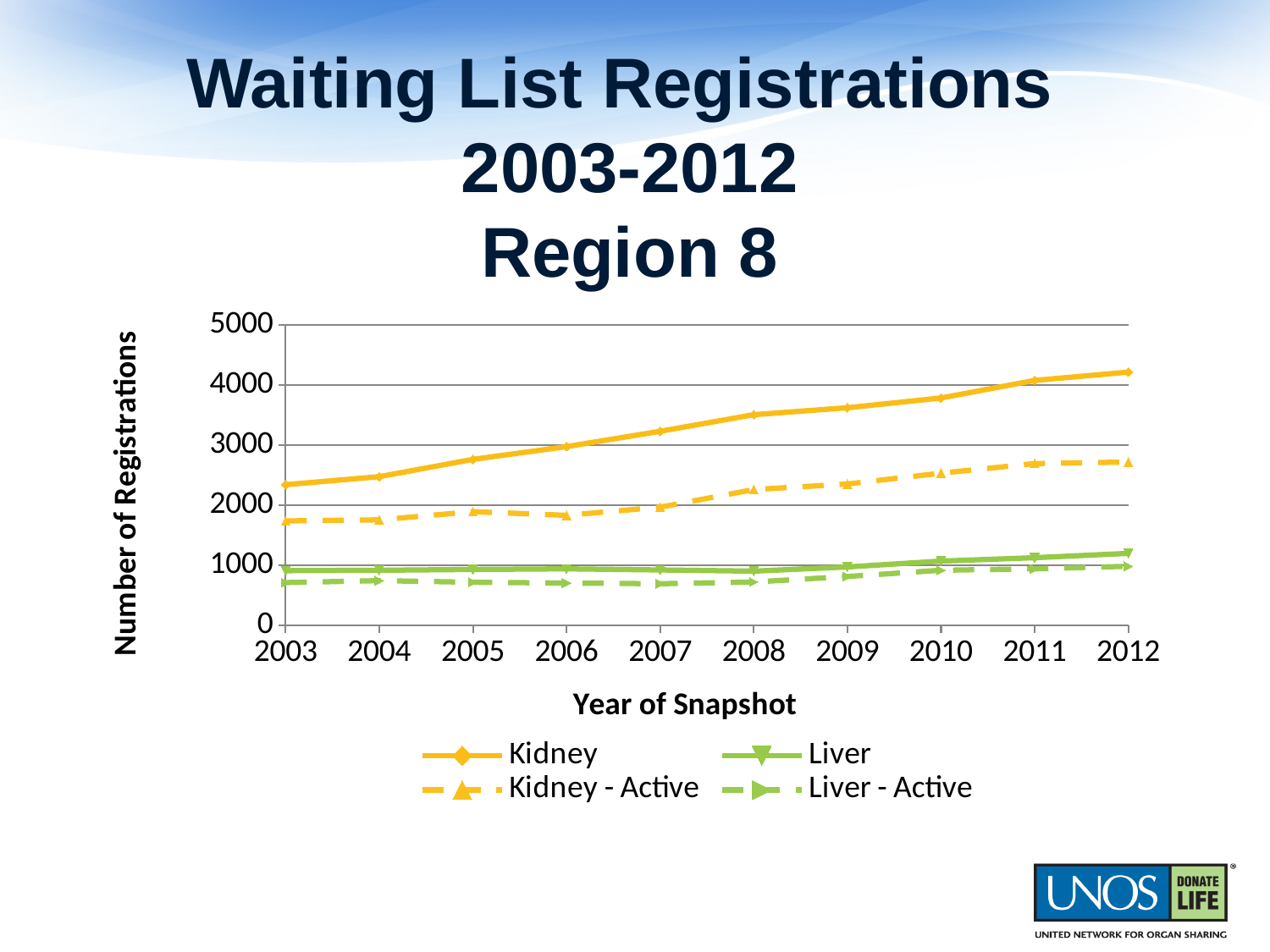
How many years are plotted along the x axis? 10 What is the label of the y axis? Number of Registrations What kind of chart is shown on the slide? line chart Is the value for Kidney in 2012 greater or less than 4000? greater In 2012, which is larger: Kidney or Liver? Kidney In which year does the Kidney series reach its highest value? 2012 Is the value for Liver - Active in 2003 greater or less than 1000? less Do the Kidney registrations rise or fall from 2003 to 2012? rise Is the value for Kidney - Active in 2003 greater or less than 2000? less How many series does the legend list? 4